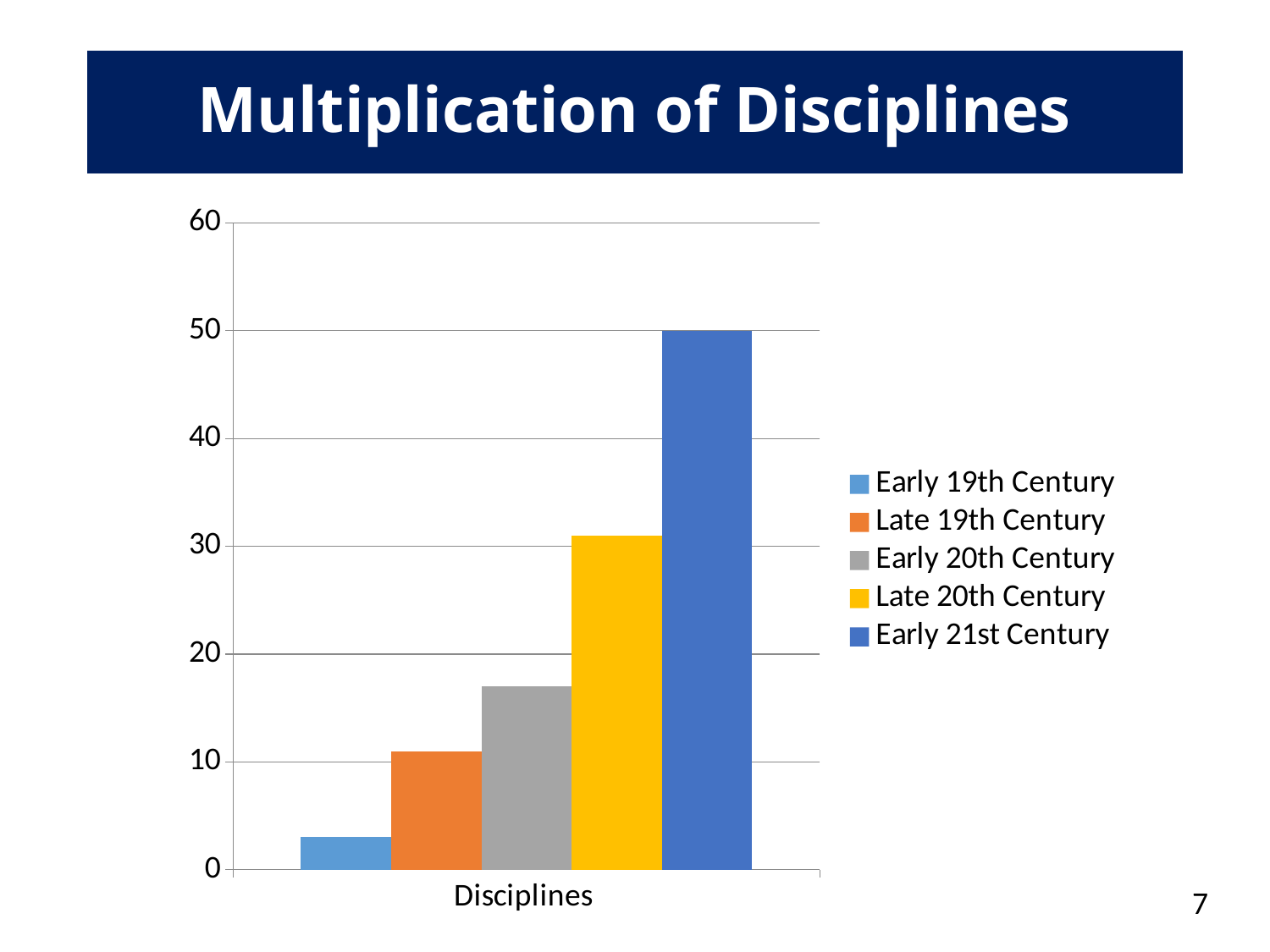
What kind of chart is shown on the slide? bar chart Do the bars rise or fall from Early 19th Century to Early 21st Century? rise How many series does the legend list? 5 Is the value for Late 19th Century greater or less than 10? greater Is the value for Early 19th Century greater or less than 10? less What is the label on the x axis of the chart? Disciplines Is the value for Early 20th Century greater or less than 20? less Which is larger, the value for Late 20th Century or the value for Early 20th Century? Late 20th Century What is the value for Early 21st Century? 50 Which series has the lowest bar? Early 19th Century Which series has the highest bar? Early 21st Century